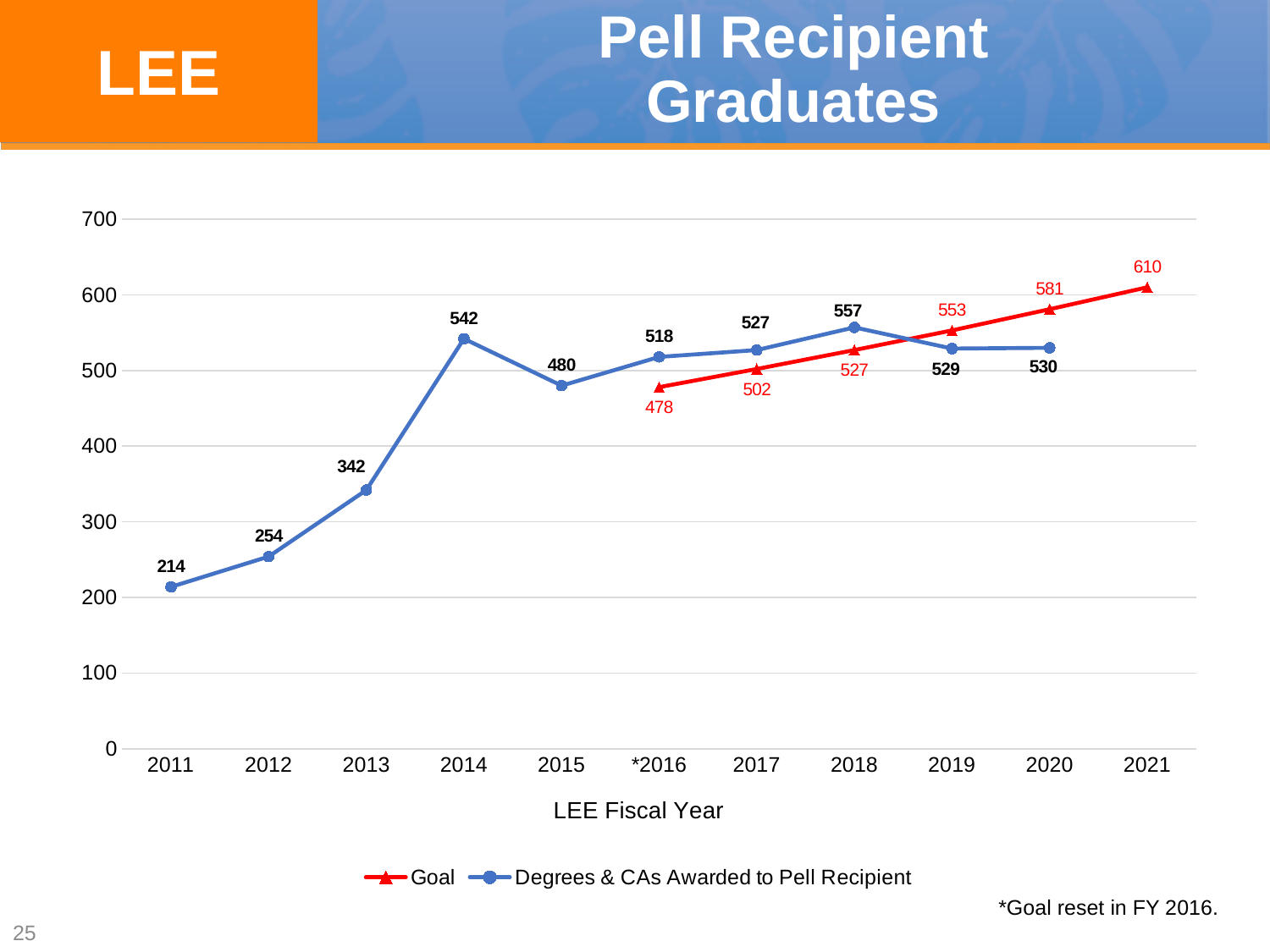
How many years are shown on the x axis? 11 In which year is the Degrees & CAs Awarded to Pell Recipient value lowest? 2011 What is the value of Degrees & CAs Awarded to Pell Recipient in 2011? 214 In which year is the Degrees & CAs Awarded to Pell Recipient value highest? 2018 What is the difference between the Goal and the Degrees & CAs Awarded to Pell Recipient in 2020? 51 How many series does the legend list? 2 What is the Goal value for 2021? 610 What kind of chart is shown on the slide? Line chart What is the value of Degrees & CAs Awarded to Pell Recipient in 2014? 542 Does the Goal series rise or fall from *2016 to 2021? Rise Which is larger in 2018, the Goal or the Degrees & CAs Awarded to Pell Recipient? Degrees & CAs Awarded to Pell Recipient What is the title of the chart? Pell Recipient Graduates